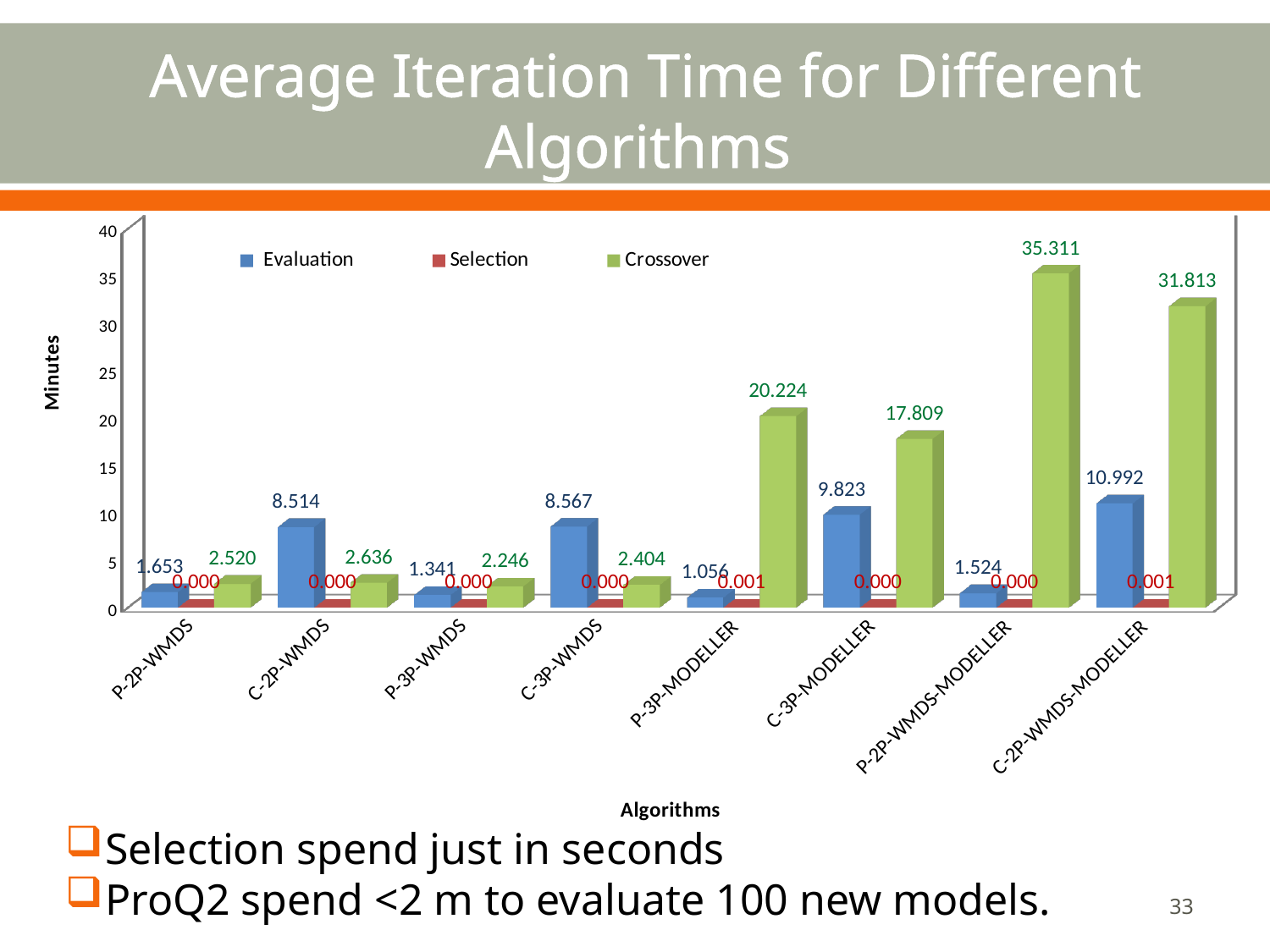
How many algorithms are shown on the x axis? 8 Which is larger, the Evaluation value for C-3P-MODELLER or the Evaluation value for C-2P-WMDS? C-3P-MODELLER What is the Crossover value for P-2P-WMDS-MODELLER? 35.311 What is the Selection value for P-3P-MODELLER? 0.001 How many series does the legend list? 3 What is the difference between the Crossover values for P-2P-WMDS-MODELLER and C-2P-WMDS-MODELLER? 3.498 What kind of chart is shown on the slide? Bar chart What is the Evaluation value for C-2P-WMDS-MODELLER? 10.992 Which algorithm has the lowest Evaluation value? P-3P-MODELLER Is the Crossover value for P-3P-MODELLER greater or less than 15? greater What is the label of the y axis? Minutes Which algorithm has the highest Crossover value? P-2P-WMDS-MODELLER